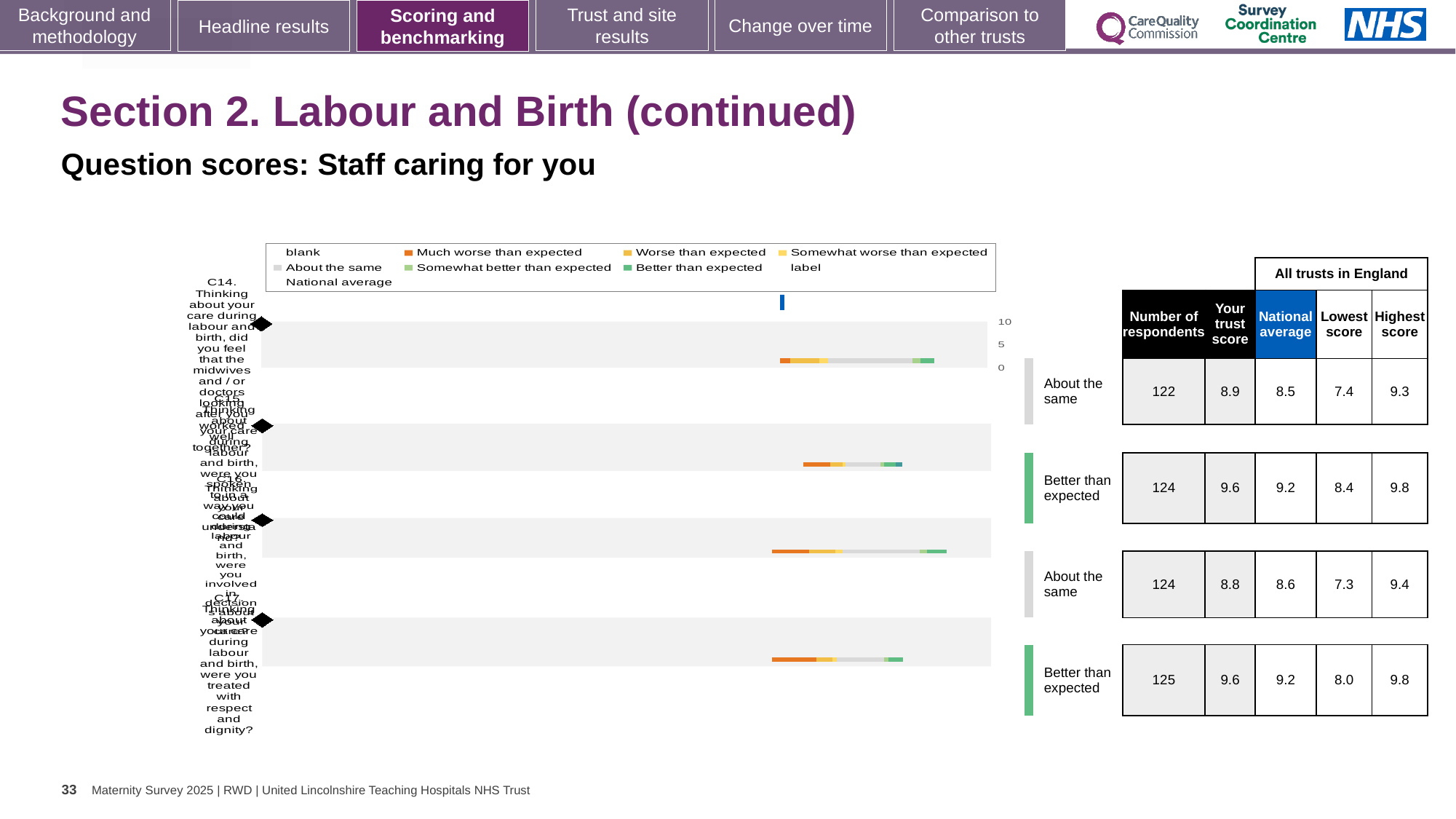
In the table beside the chart, what is the lowest score for the third row (C16)? 7.3 What colour does the legend use for 'Much worse than expected'? orange In the table beside the chart, what is the number of respondents for the first row (C14)? 122 In the table beside the chart, what is the national average for the first row (C14)? 8.5 How many question rows (bars) does the chart show? 4 For the last row (C17), what is the difference between the trust score and the national average? 0.4 In the table beside the chart, what is the trust score for the last row (C17)? 9.6 For the first row (C14), which is larger: the trust score or the national average? trust score How many entries does the chart's legend list? 9 What kind of chart is shown on the slide? bar chart In the table beside the chart, what is the highest score for the second row (C15)? 9.8 What colour does the legend use for 'Better than expected'? green